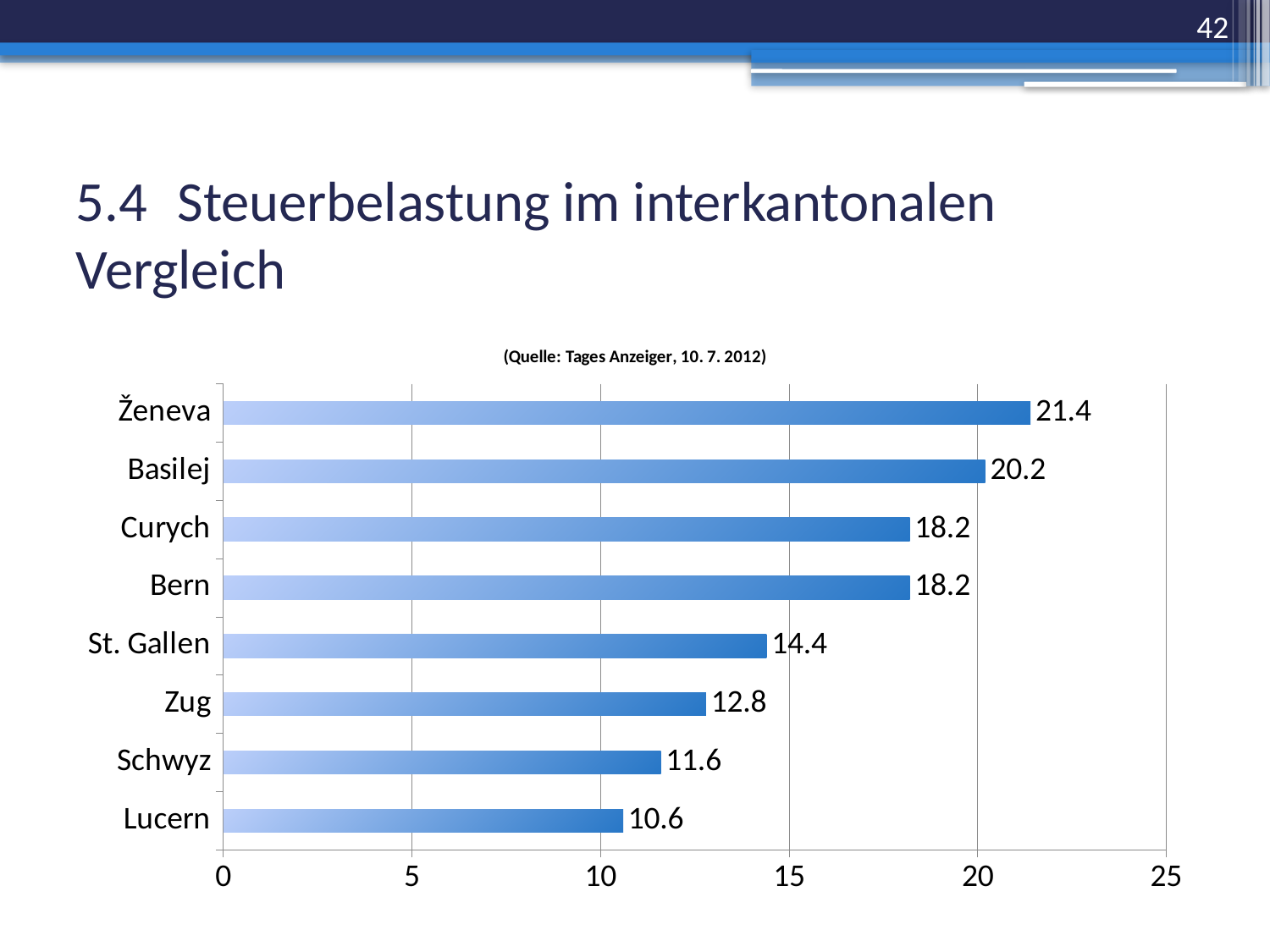
What is the value for St. Gallen? 14.4 Is the value for Basilej greater or less than 20? greater How many categories are shown in the chart? 8 Which category has the highest value? Ženeva What kind of chart is shown on the slide? Bar chart What is the value for Lucern? 10.6 What is the difference between the values for Ženeva and Basilej? 1.2 What is the value for Ženeva? 21.4 What is the chart's title? (Quelle: Tages Anzeiger, 10. 7. 2012) What is the difference between the values for Zug and Schwyz? 1.2 Which category has the lowest value? Lucern Which is larger, the value for St. Gallen or the value for Zug? St. Gallen